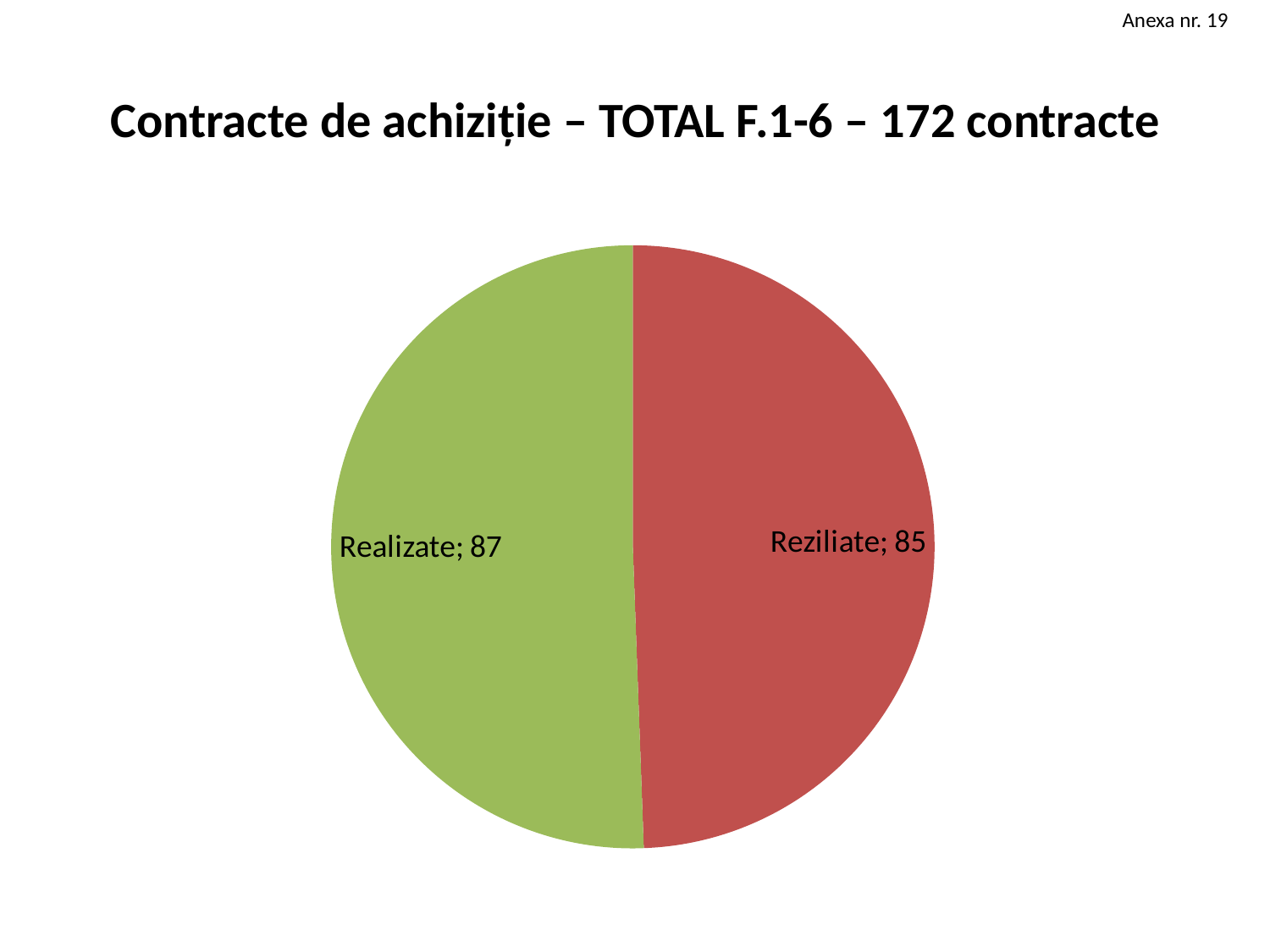
What is the total of the two slices in the pie chart? 172 What is the difference between the Realizate and Reziliate values in the pie chart? 2 Which category has the lowest value in the pie chart? Reziliate Which category has the highest value in the pie chart? Realizate What is the title of the chart on the slide? Contracte de achiziție – TOTAL F.1-6 – 172 contracte What type of chart is shown on the slide? pie chart How many contracts are labelled as Realizate in the pie chart? 87 Which slice of the pie chart has the larger value, Realizate or Reziliate? Realizate How many slices does the pie chart have? 2 How many contracts are labelled as Reziliate in the pie chart? 85 What colour is the Reziliate slice in the pie chart? red